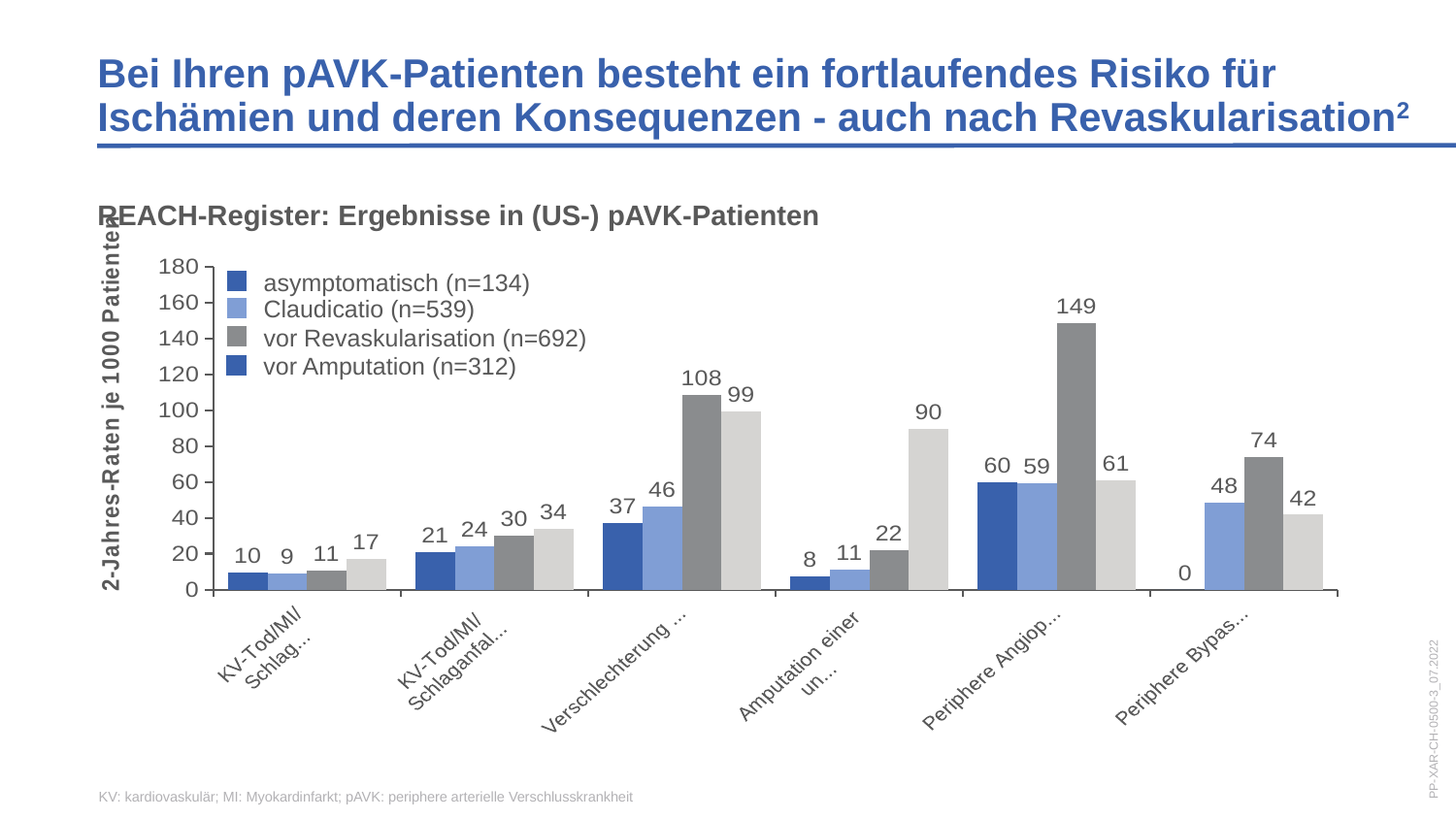
What is the value for 'Claudicatio' in the 'Verschlechterung ...' category? 46 What is the value for 'vor Revaskularisation' in the 'Periphere Angiop...' category? 149 Which is larger: the 'vor Revaskularisation' value for 'Verschlechterung ...' or for 'Periphere Bypas...'? Verschlechterung ... How many category groups are plotted along the x axis? 6 In the 'Verschlechterung ...' category, what is the difference between the 'vor Revaskularisation' value and the 'asymptomatisch' value? 71 What kind of chart is shown on the slide? bar chart Is the 'vor Revaskularisation' value for 'Periphere Angiop...' greater or less than 140? greater What is the highest value shown in the chart? 149 How many series does the legend list? 4 What is the y-axis title of the chart? 2-Jahres-Raten je 1000 Patienten What sample size (n) does the legend give for 'Claudicatio'? n=539 What is the value for 'asymptomatisch' in the 'Periphere Bypas...' category? 0